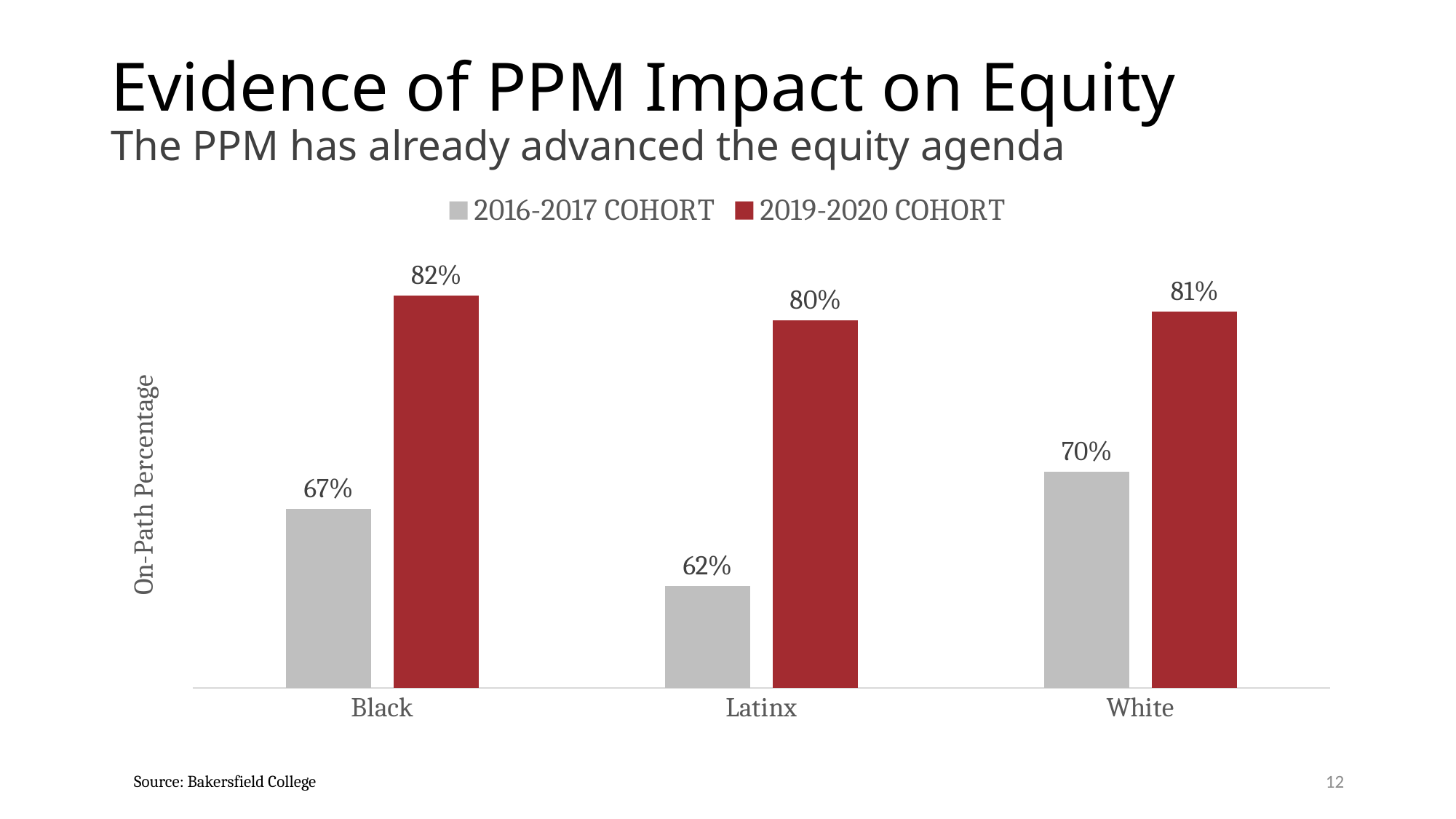
What is the on-path percentage for Black students in the 2016-2017 cohort? 67% What is the on-path percentage for White students in the 2016-2017 cohort? 70% What is the on-path percentage for Latinx students in the 2019-2020 cohort? 80% How many series does the legend list? 2 Which is larger: the 2016-2017 cohort on-path percentage for White students or for Black students? White What is the difference between the 2019-2020 cohort and the 2016-2017 cohort on-path percentage for Latinx students? 18% What is the difference between the 2019-2020 cohort and the 2016-2017 cohort on-path percentage for Black students? 15% What is the label on the vertical axis of the chart? On-Path Percentage Which group has the lowest on-path percentage in the 2016-2017 cohort? Latinx How many groups are shown on the x axis of the chart? 3 What kind of chart is shown on the slide? Bar chart Which group has the highest on-path percentage in the 2019-2020 cohort? Black